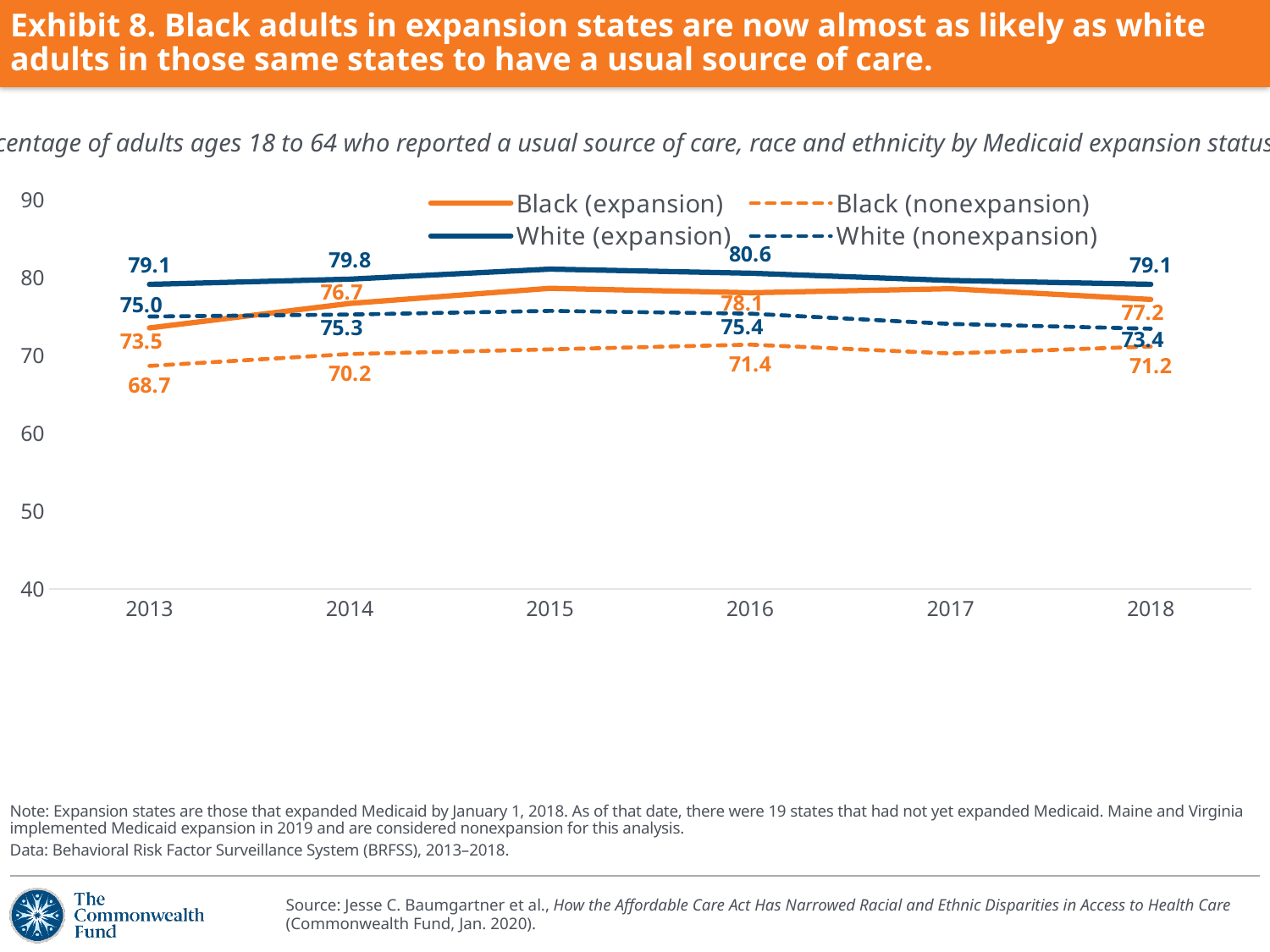
What kind of chart is shown on the slide? Line chart What is the difference between White (expansion) and Black (expansion) in 2013? 5.6 What is the value for Black (nonexpansion) in 2016? 71.4 Which series has the lowest value in 2013? Black (nonexpansion) How many series does the legend list? 4 What is the value for White (nonexpansion) in 2018? 73.4 What is the difference between White (expansion) and Black (expansion) in 2018? 1.9 In 2018, which is larger: Black (expansion) or White (nonexpansion)? Black (expansion) What is the value for White (expansion) in 2014? 79.8 Is the value for Black (expansion) in 2015 greater or less than 80? less What is the value for Black (expansion) in 2013? 73.5 How many years are shown on the x axis? 6